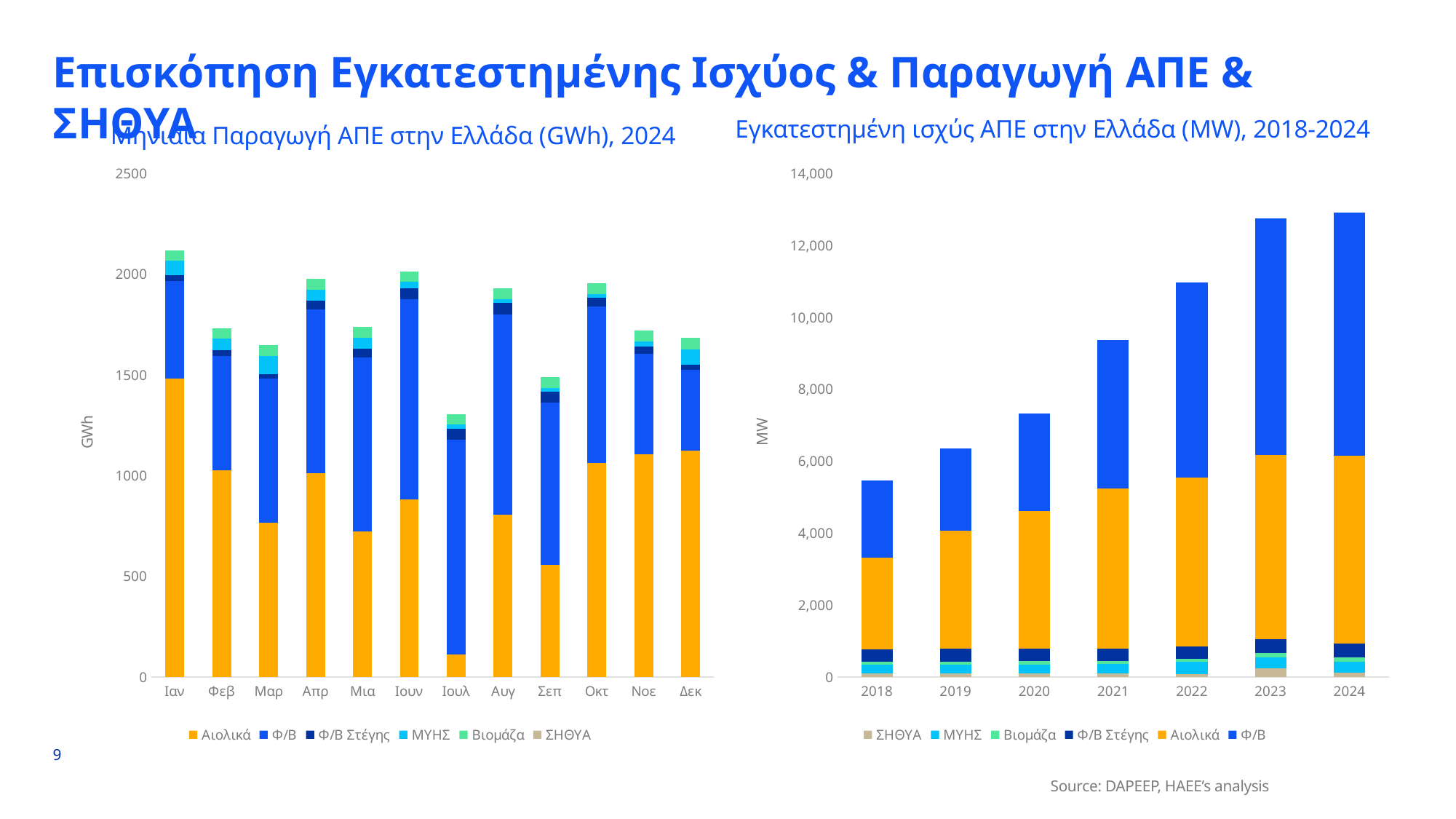
In the right chart 'Εγκατεστημένη ισχύς ΑΠΕ στην Ελλάδα (MW), 2018-2024', is the total for 2018 greater or less than 6,000? less In the right chart 'Εγκατεστημένη ισχύς ΑΠΕ στην Ελλάδα (MW), 2018-2024', does total installed capacity rise or fall from 2018 to 2024? Rise In the left chart 'Μηνιαία Παραγωγή ΑΠΕ στην Ελλάδα (GWh), 2024', which is larger, the total for Ιαν or the total for Φεβ? Ιαν How many series does the legend of the left chart 'Μηνιαία Παραγωγή ΑΠΕ στην Ελλάδα (GWh), 2024' list? 6 In the left chart 'Μηνιαία Παραγωγή ΑΠΕ στην Ελλάδα (GWh), 2024', how many months are shown on the x axis? 12 In the left chart 'Μηνιαία Παραγωγή ΑΠΕ στην Ελλάδα (GWh), 2024', is the Αιολικά value for Ιουλ greater or less than 500? less In the left chart 'Μηνιαία Παραγωγή ΑΠΕ στην Ελλάδα (GWh), 2024', which month has the lowest total production? Ιουλ In the left chart 'Μηνιαία Παραγωγή ΑΠΕ στην Ελλάδα (GWh), 2024', is the total for Ιουλ greater or less than 1500? less In the right chart 'Εγκατεστημένη ισχύς ΑΠΕ στην Ελλάδα (MW), 2018-2024', how many years are shown on the x axis? 7 In the left chart 'Μηνιαία Παραγωγή ΑΠΕ στην Ελλάδα (GWh), 2024', which month has the highest total production? Ιαν What kind of chart is the left chart, 'Μηνιαία Παραγωγή ΑΠΕ στην Ελλάδα (GWh), 2024'? Stacked bar chart In the right chart 'Εγκατεστημένη ισχύς ΑΠΕ στην Ελλάδα (MW), 2018-2024', which year has the lowest total installed capacity? 2018